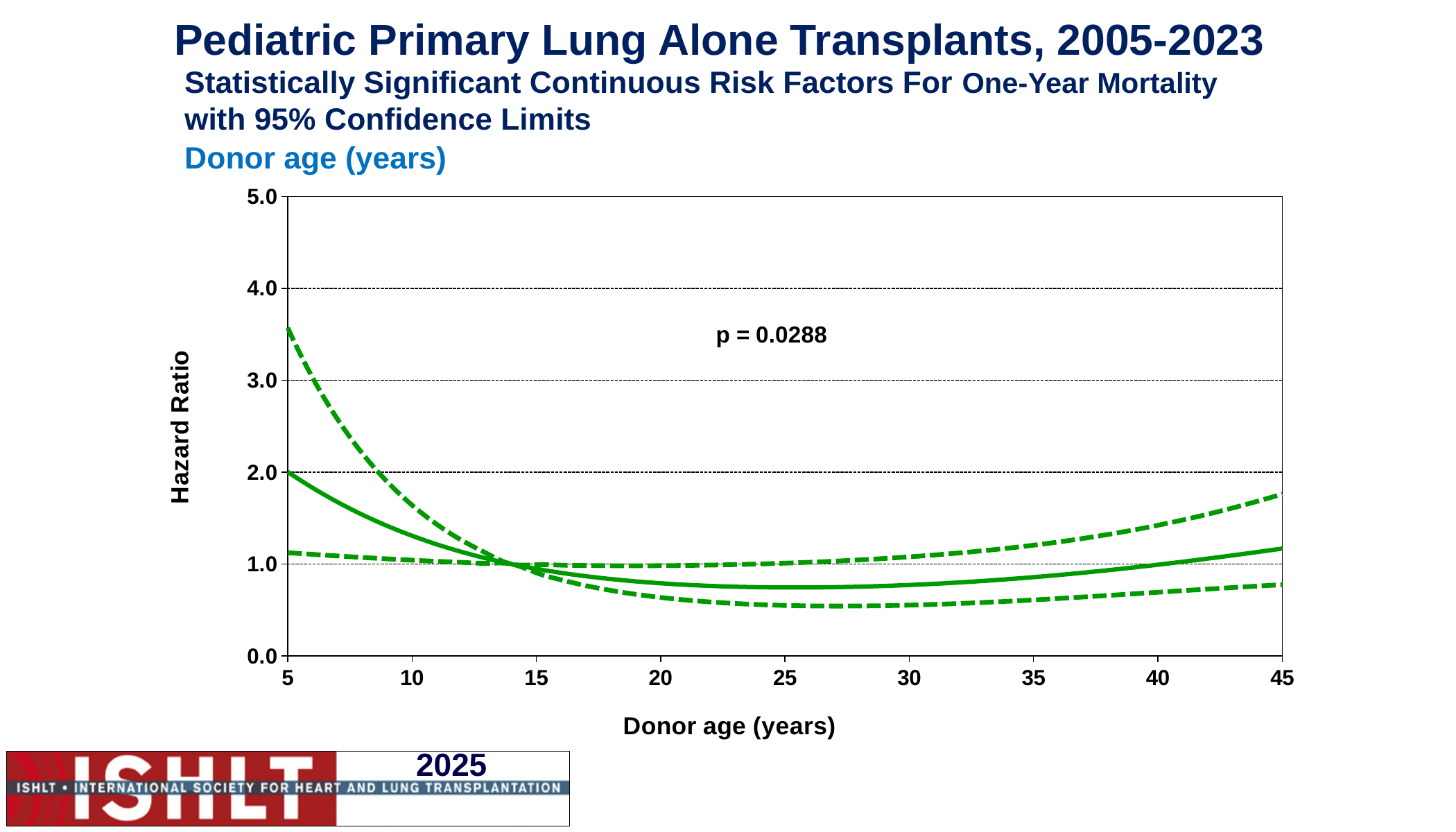
Is the upper dashed confidence limit at donor age 5 greater or less than 3.0? greater What is the highest value shown on the y axis? 5.0 Does the solid hazard ratio line rise or fall as donor age increases from 30 to 45 years? rise Is the hazard ratio of the solid line at donor age 25 greater or less than 1.0? less Does the solid hazard ratio line rise or fall as donor age increases from 5 to 25 years? fall What p-value is printed on the chart? p = 0.0288 How many lines are plotted on the chart? 3 What is the label of the x axis? Donor age (years) Is the hazard ratio of the solid line at donor age 5 greater or less than 1.0? greater What kind of chart is shown on the slide? line chart What is the label of the y axis? Hazard Ratio